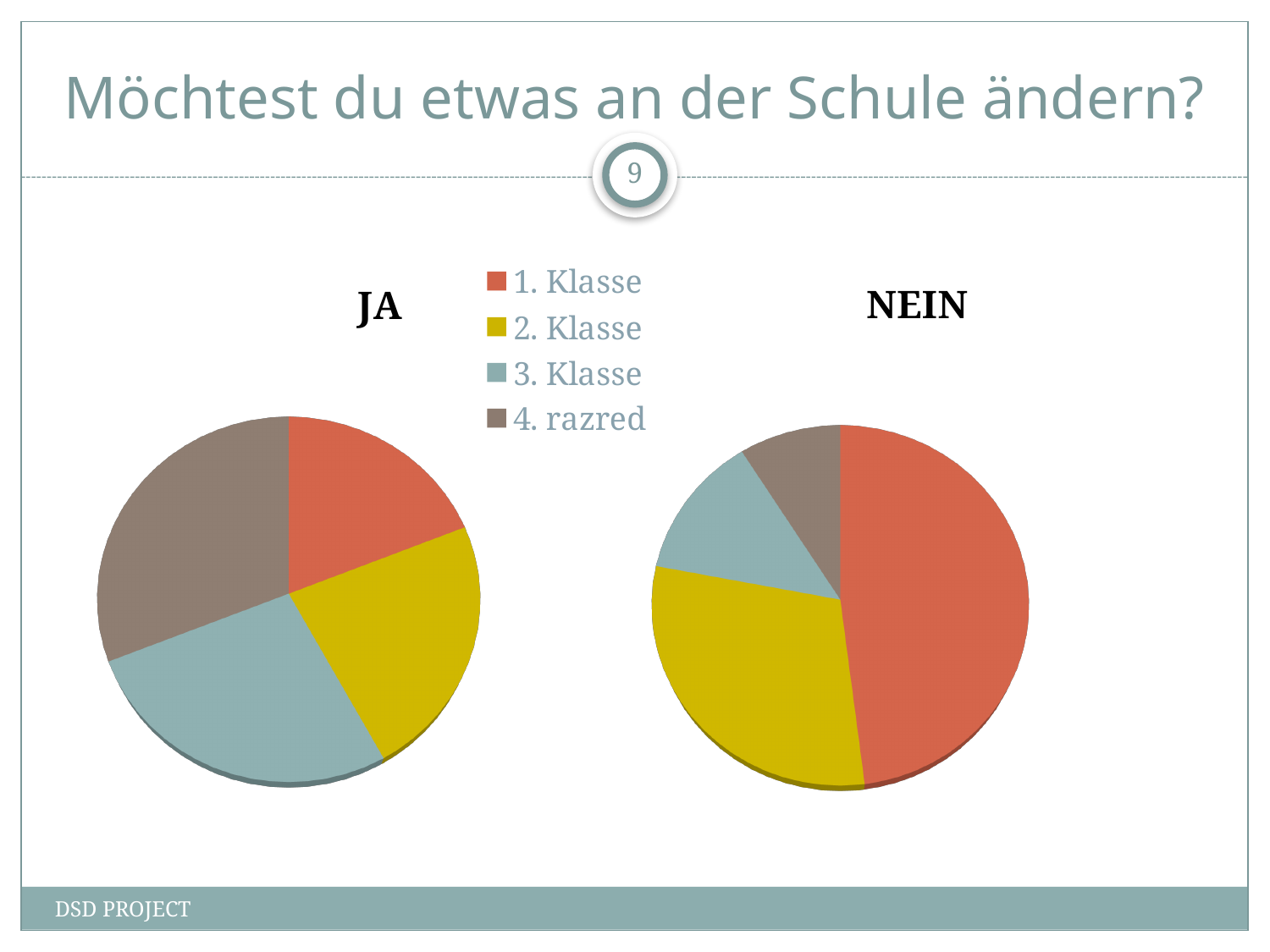
In the NEIN pie chart, which category has the largest slice? 1. Klasse What kind of chart is the JA chart? pie chart How many slices does the JA pie chart have? 4 In the NEIN pie chart, which category has the smallest slice? 4. razred What kind of chart is the NEIN chart? pie chart How many categories does the legend list for the pie charts? 4 In the JA pie chart, which slice is larger, 1. Klasse or 4. razred? 4. razred Which colour represents 3. Klasse in the legend? teal (grey-blue) In the JA pie chart, which category has the smallest slice? 1. Klasse In the NEIN pie chart, which slice is larger, 1. Klasse or 2. Klasse? 1. Klasse How many slices does the NEIN pie chart have? 4 In the NEIN pie chart, which slice is larger, 2. Klasse or 3. Klasse? 2. Klasse